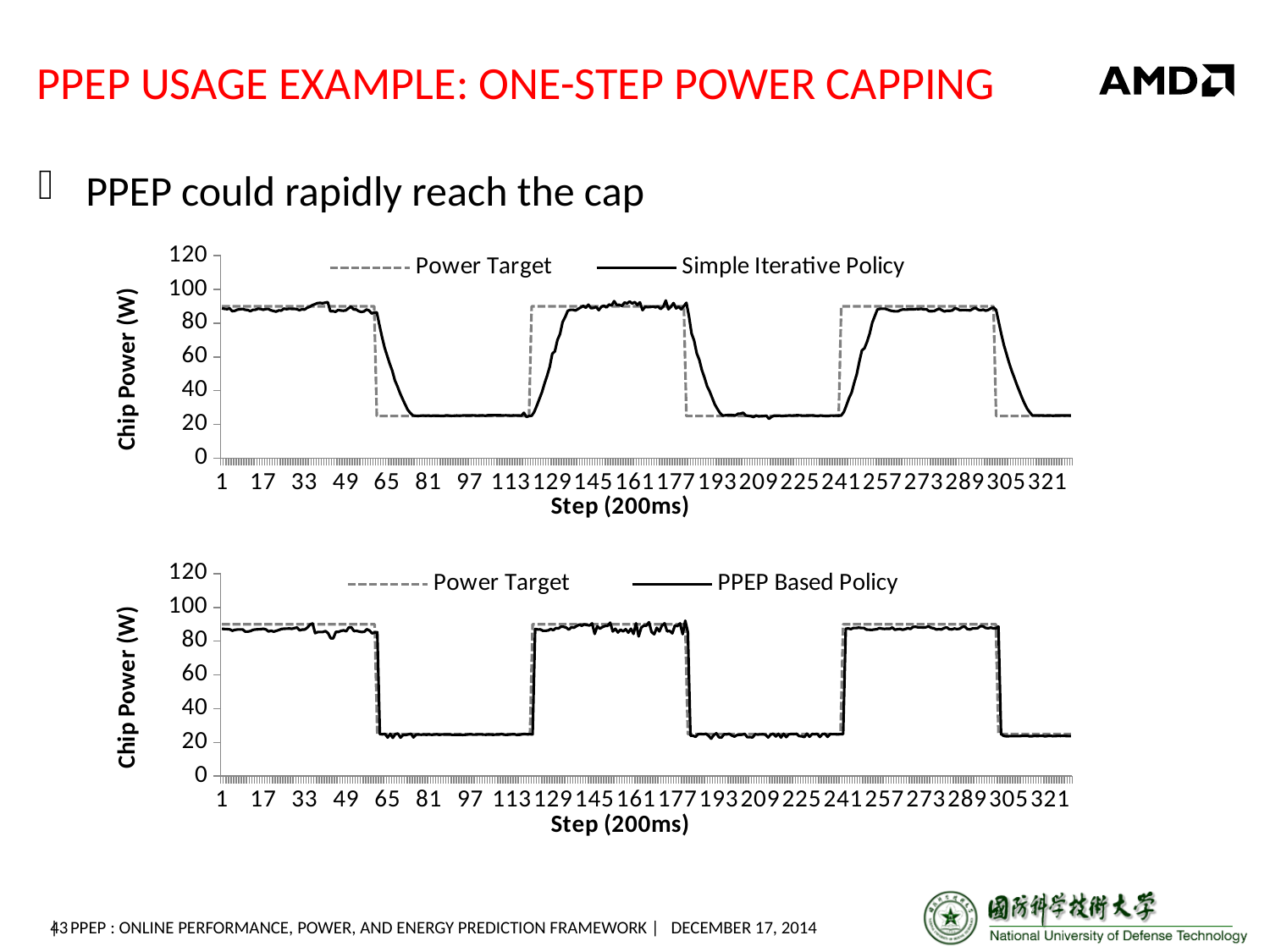
In the bottom chart, what is the name of the solid-line series in the legend? PPEP Based Policy In the top chart, how many series does the legend list? 2 In the bottom chart, how many series does the legend list? 2 In the top chart, is the Power Target value at step 81 greater or less than 40? less In the bottom chart, is the Power Target value at step 209 greater or less than 40? less In the bottom chart, is the PPEP Based Policy value at step 273 greater or less than 60? greater What kind of chart is the bottom chart on the slide? line chart What kind of chart is the top chart on the slide? line chart In the top chart, what are the two series named in the legend? Power Target and Simple Iterative Policy